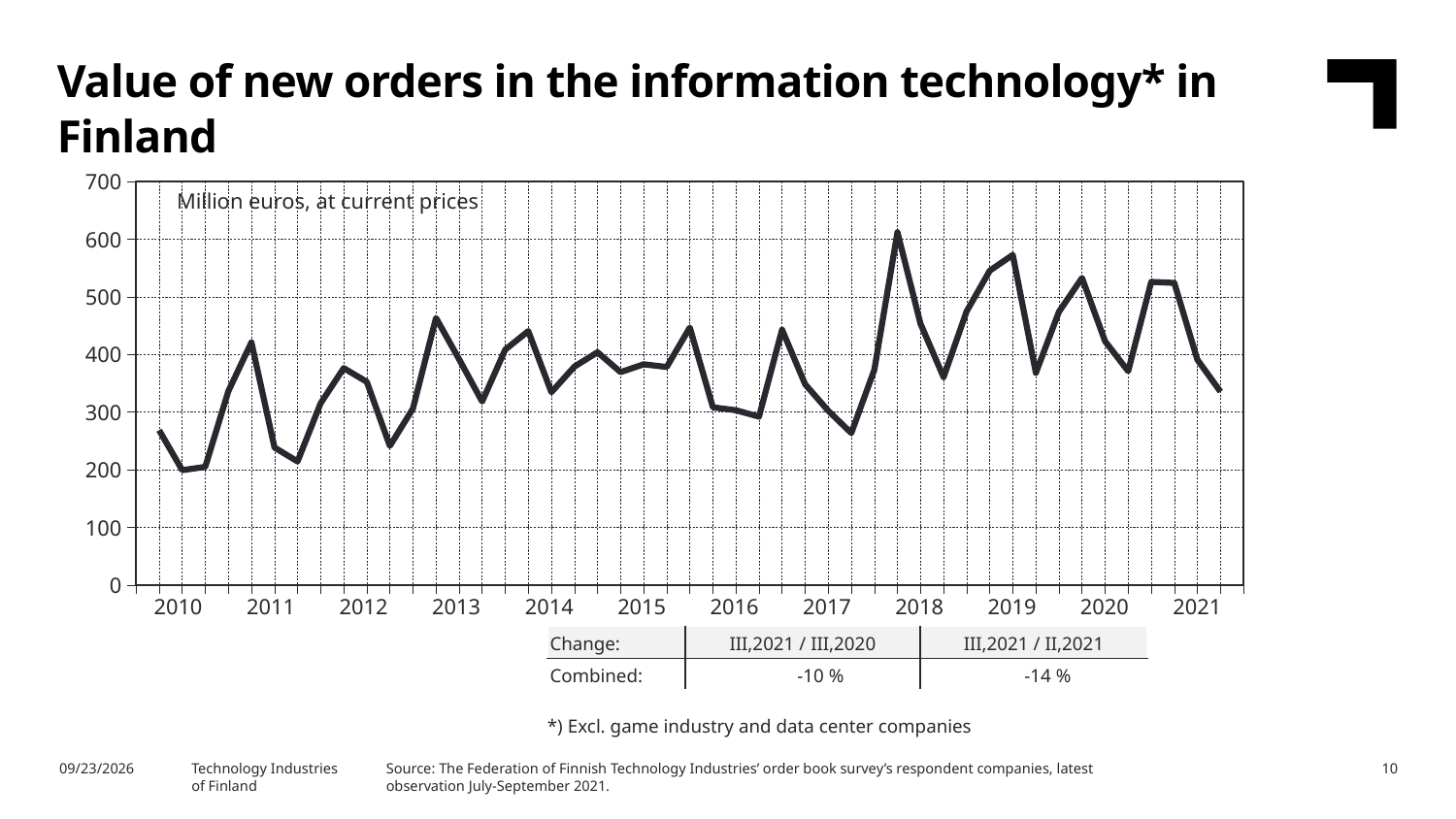
What kind of chart is shown on the slide? line chart Is the last plotted value, in 2021, greater or less than 400? less Is the highest peak of the line, in 2018, greater or less than 500? greater What is the combined change for III,2021 / III,2020 shown in the table below the chart? -10 % What is the combined change for III,2021 / II,2021 shown in the table below the chart? -14 % In which year does the line reach its lowest value? 2010 In which year does the line reach its highest value? 2018 Is the value at the start of 2016 greater or less than 400? less Does the line rise or fall over the course of 2021? fall How many years are labeled on the x axis? 12 In what unit are the values on the chart expressed, according to the label inside the plot area? Million euros, at current prices